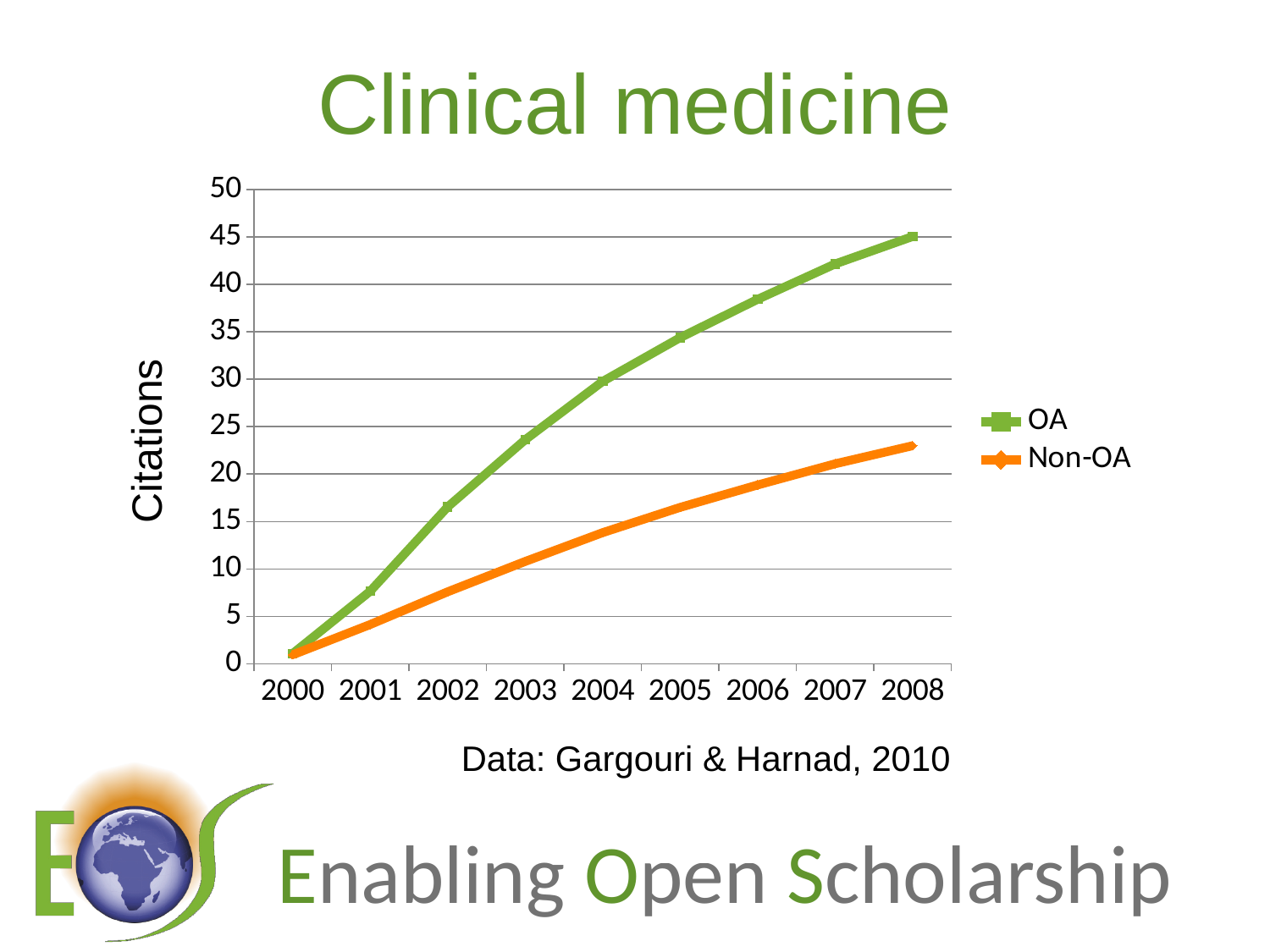
Is the Non-OA value for 2004 greater or less than 20? less How many years are shown along the x axis? 9 Is the OA value for 2003 greater or less than 20? greater What is the label on the y axis? Citations In which year does the OA series reach its highest value? 2008 Do the Non-OA citations rise or fall from 2000 to 2008? rise Do the OA citations rise or fall from 2000 to 2008? rise What kind of chart is shown on the slide? line chart In 2008, which series has more citations, OA or Non-OA? OA Is the Non-OA value for 2008 greater or less than 25? less How many series does the legend list? 2